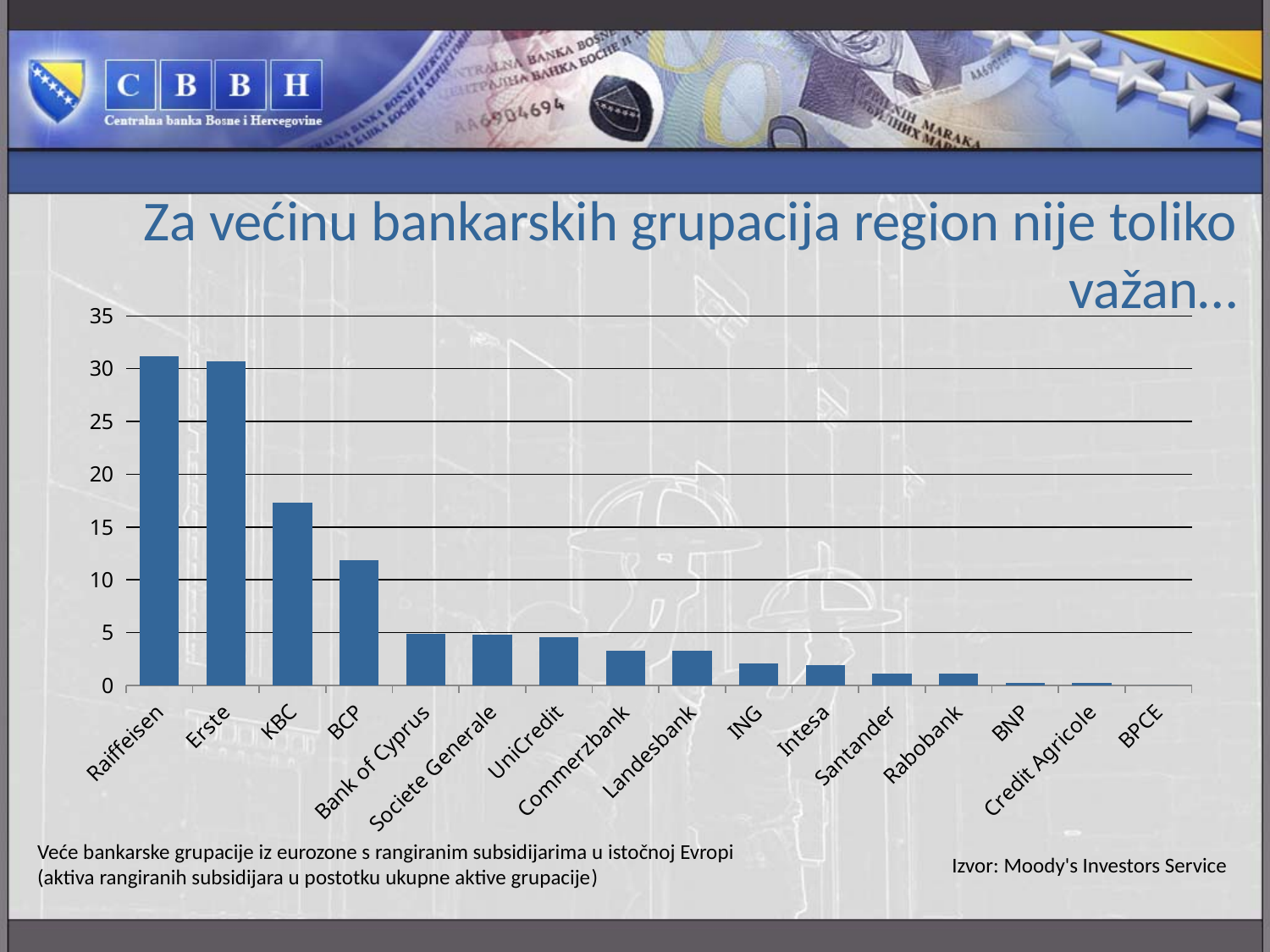
What source is cited for the chart data? Moody's Investors Service Do the values rise or fall moving from left to right along the x axis? fall Is the value for Raiffeisen greater or less than 30? greater How many banking groups are shown on the x axis of the chart? 16 Is the value for KBC greater or less than 20? less What kind of chart is shown on the slide? bar chart Is the value for Commerzbank greater or less than 5? less Which has the larger value, KBC or BCP? KBC Which has the larger value, Bank of Cyprus or Santander? Bank of Cyprus